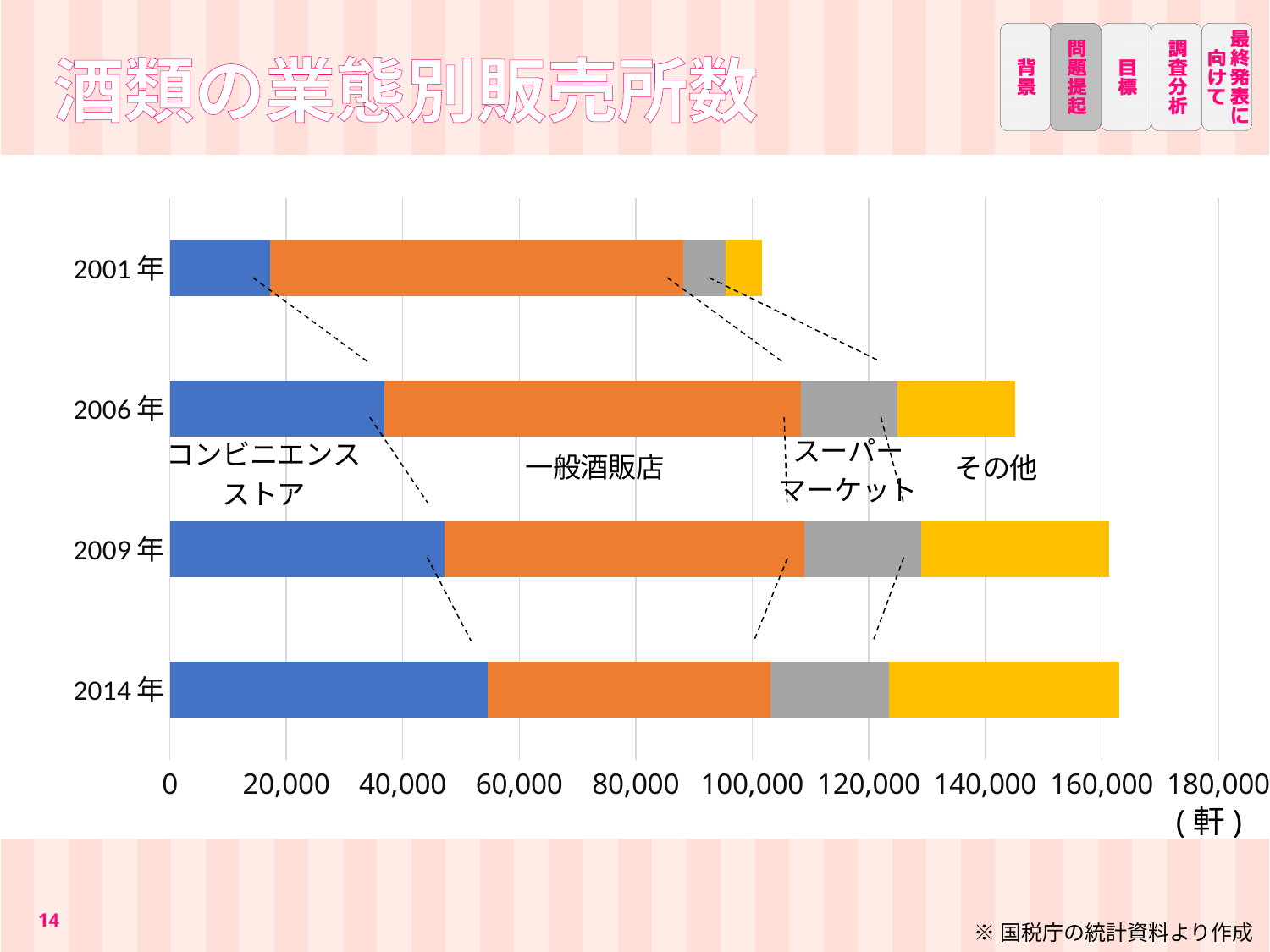
Is the total for 2001年 greater or less than 120,000? less Does the コンビニエンスストア segment rise or fall from 2001年 to 2014年? rise What is the title of the chart on the slide? 酒類の業態別販売所数 Which year has the shortest total bar? 2001年 Which is larger, the total for 2014年 or the total for 2001年? 2014年 Is the total for 2014年 greater or less than 140,000? greater What unit is shown for the horizontal axis? 軒 Is the コンビニエンスストア value for 2001年 greater or less than 20,000? less What kind of chart is shown on the slide? Stacked bar chart How many years (categories) are plotted on the chart? 4 How many series (store types) does the chart show? 4